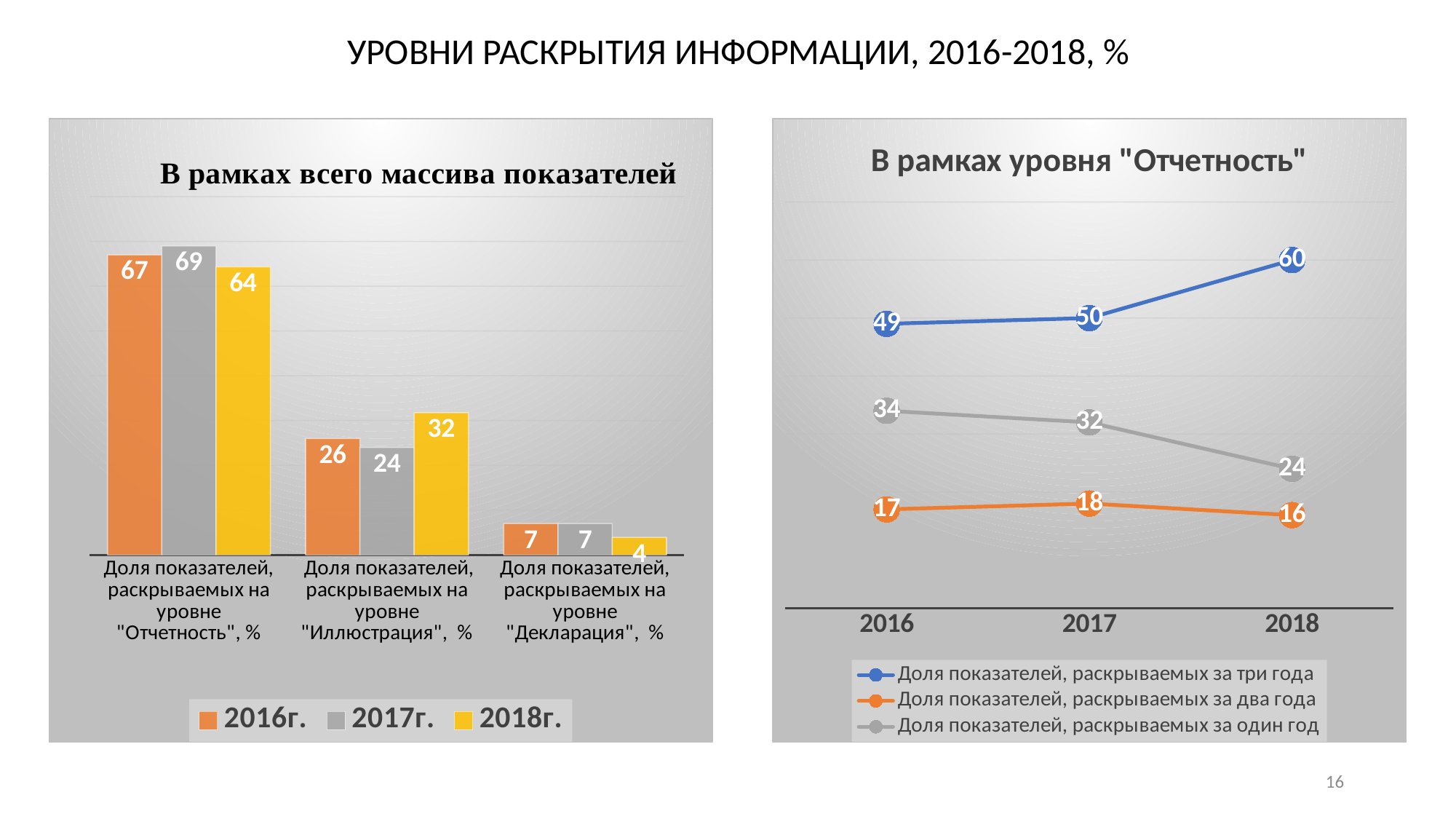
In the chart titled "В рамках всего массива показателей", how many series does the legend list? 3 In the chart titled "В рамках уровня "Отчетность"", does the series "Доля показателей, раскрываемых за один год" rise or fall from 2016 to 2018? Fall What kind of chart is the one titled "В рамках уровня "Отчетность""? Line chart In the chart titled "В рамках всего массива показателей", which year has the highest value for the category "Доля показателей, раскрываемых на уровне "Отчетность", %"? 2017г. In the chart titled "В рамках уровня "Отчетность"", what is the value for "Доля показателей, раскрываемых за один год" in 2016? 34 In the chart titled "В рамках уровня "Отчетность"", which is larger in 2017: "Доля показателей, раскрываемых за два года" or "Доля показателей, раскрываемых за один год"? Доля показателей, раскрываемых за один год In the chart titled "В рамках уровня "Отчетность"", what is the value for "Доля показателей, раскрываемых за три года" in 2018? 60 In the chart titled "В рамках всего массива показателей", what is the difference between the 2018г. and 2017г. values for the category "Доля показателей, раскрываемых на уровне "Иллюстрация", %"? 8 In the chart titled "В рамках всего массива показателей", what is the value for 2018г. for the category "Доля показателей, раскрываемых на уровне "Иллюстрация", %"? 32 In the chart titled "В рамках уровня "Отчетность"", what is the difference between the 2018 and 2016 values for "Доля показателей, раскрываемых за три года"? 11 In the chart titled "В рамках всего массива показателей", what is the value for 2017г. for the category "Доля показателей, раскрываемых на уровне "Отчетность", %"? 69 What kind of chart is the one titled "В рамках всего массива показателей"? Bar chart